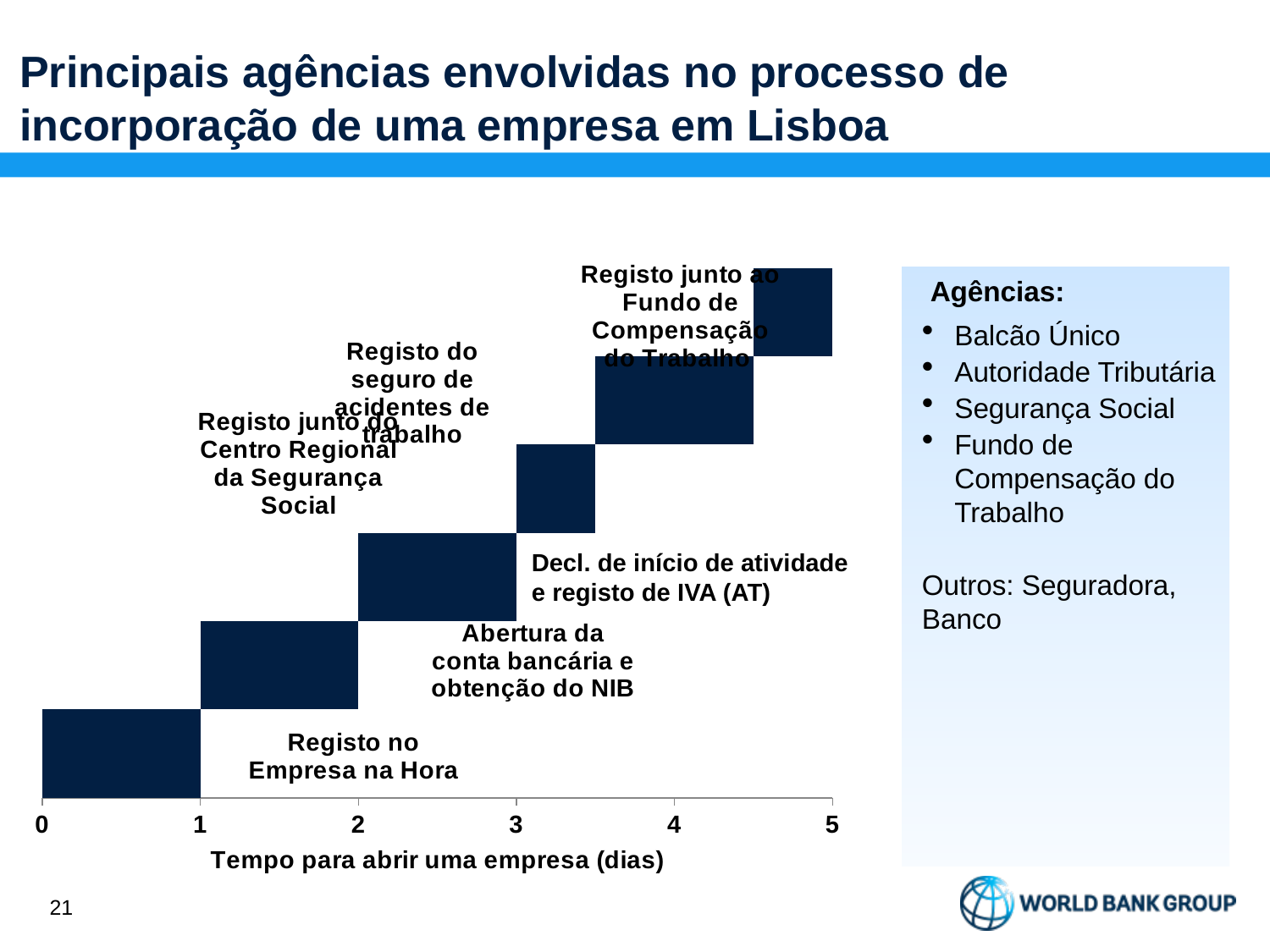
Is the end of the step 'Registo do seguro de acidentes de trabalho' greater or less than 4 days? greater What kind of chart is shown on the slide? Bar chart How many steps (bars) are shown in the chart? 6 On which day does the step 'Registo no Empresa na Hora' end? 1 Which step is the first one in the process shown in the chart? Registo no Empresa na Hora What is the title of the x axis of the chart? Tempo para abrir uma empresa (dias) On which day does the step 'Abertura da conta bancária e obtenção do NIB' start? 1 Which step takes longer: 'Registo no Empresa na Hora' or 'Registo junto ao Fundo de Compensação do Trabalho'? Registo no Empresa na Hora What is the highest value shown on the x axis of the chart? 5 What is the total time in days to open a company according to the chart (where the last bar ends)? 5 On which day does the step 'Decl. de início de atividade e registo de IVA (AT)' end? 3 Is the end of the step 'Registo junto do Centro Regional da Segurança Social' greater or less than 4 days? less